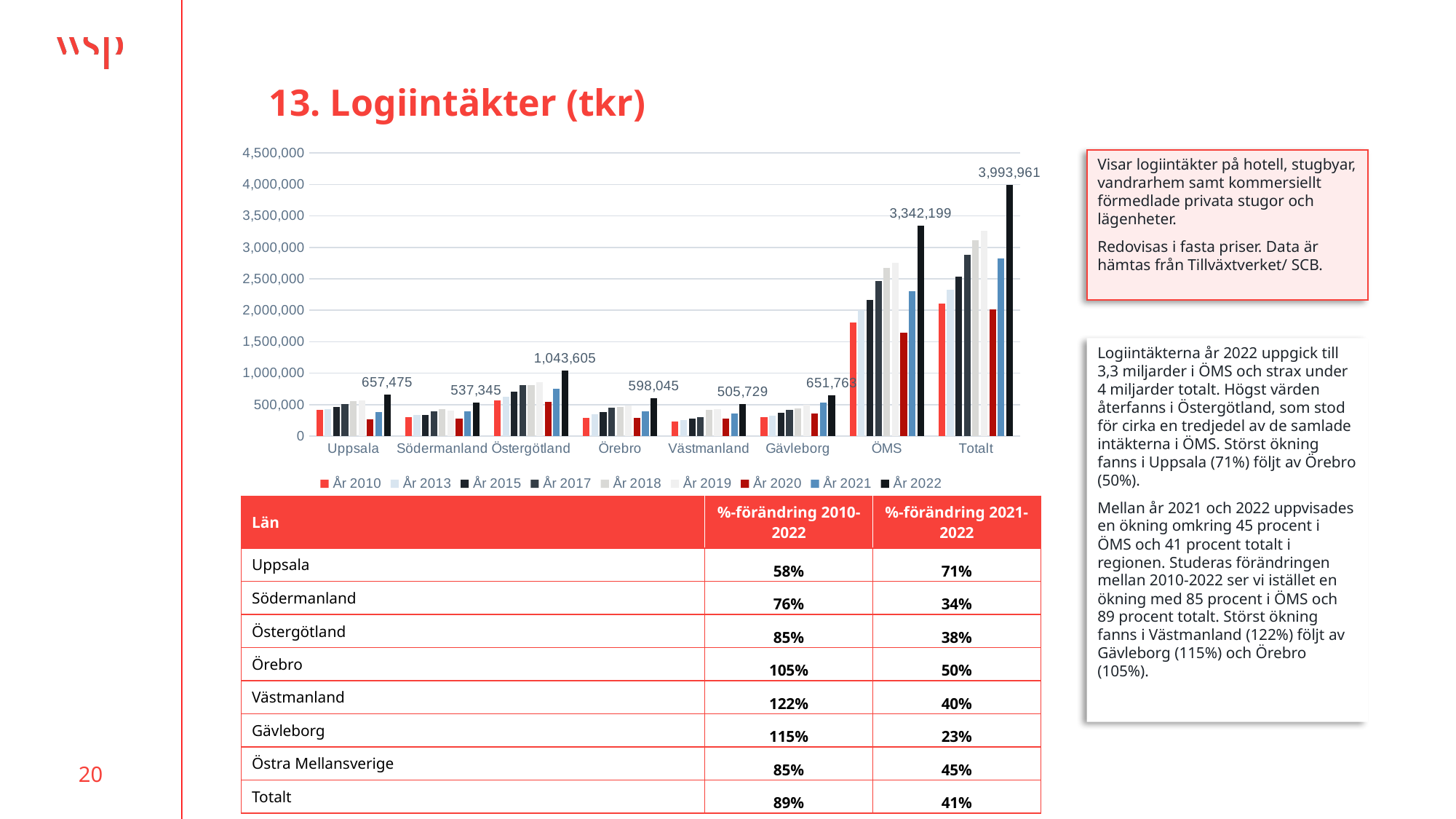
What is the difference between the År 2022 values for Totalt and ÖMS? 651,762 Among the six individual counties (excluding ÖMS and Totalt), which has the lowest År 2022 value? Västmanland What kind of chart is shown on the slide? Bar chart What is the value for Uppsala in the År 2022 series? 657,475 How many categories are shown on the x axis of the chart? 8 Is the År 2010 value for ÖMS greater or less than 1,500,000? greater Among the six individual counties (excluding ÖMS and Totalt), which has the highest År 2022 value? Östergötland Which has the larger År 2022 value, Örebro or Södermanland? Örebro What is the value for Östergötland in the År 2022 series? 1,043,605 How many series does the chart legend list? 9 What is the value for ÖMS in the År 2022 series? 3,342,199 What is the value for Totalt in the År 2022 series? 3,993,961